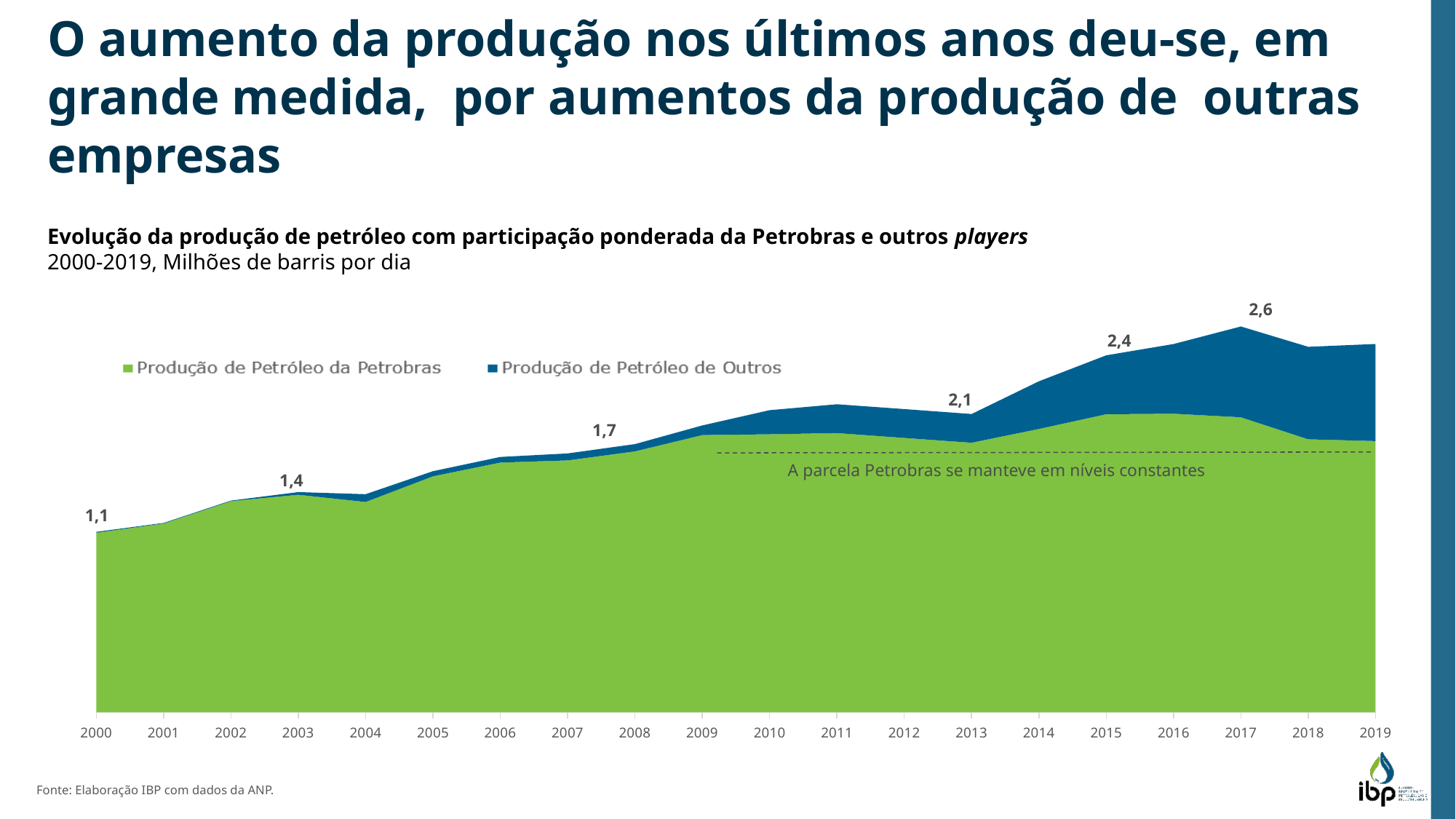
Which is larger, the labelled total for 2013 or the labelled total for 2015? 2015 What is the total production value labelled for 2000? 1,1 How many years are shown on the x axis of the chart? 20 What is the total production value labelled for 2017? 2,6 Does total production generally rise or fall from 2000 to 2019? Rise Which year has the lowest total production in the chart? 2000 What is the total production value labelled for 2008? 1,7 What is the total production value labelled for 2003? 1,4 What is the difference between the labelled total for 2017 and the labelled total for 2000? 1,5 What kind of chart is shown on the slide? Stacked area chart Which year has the highest total production in the chart? 2017 How many series does the legend list? 2